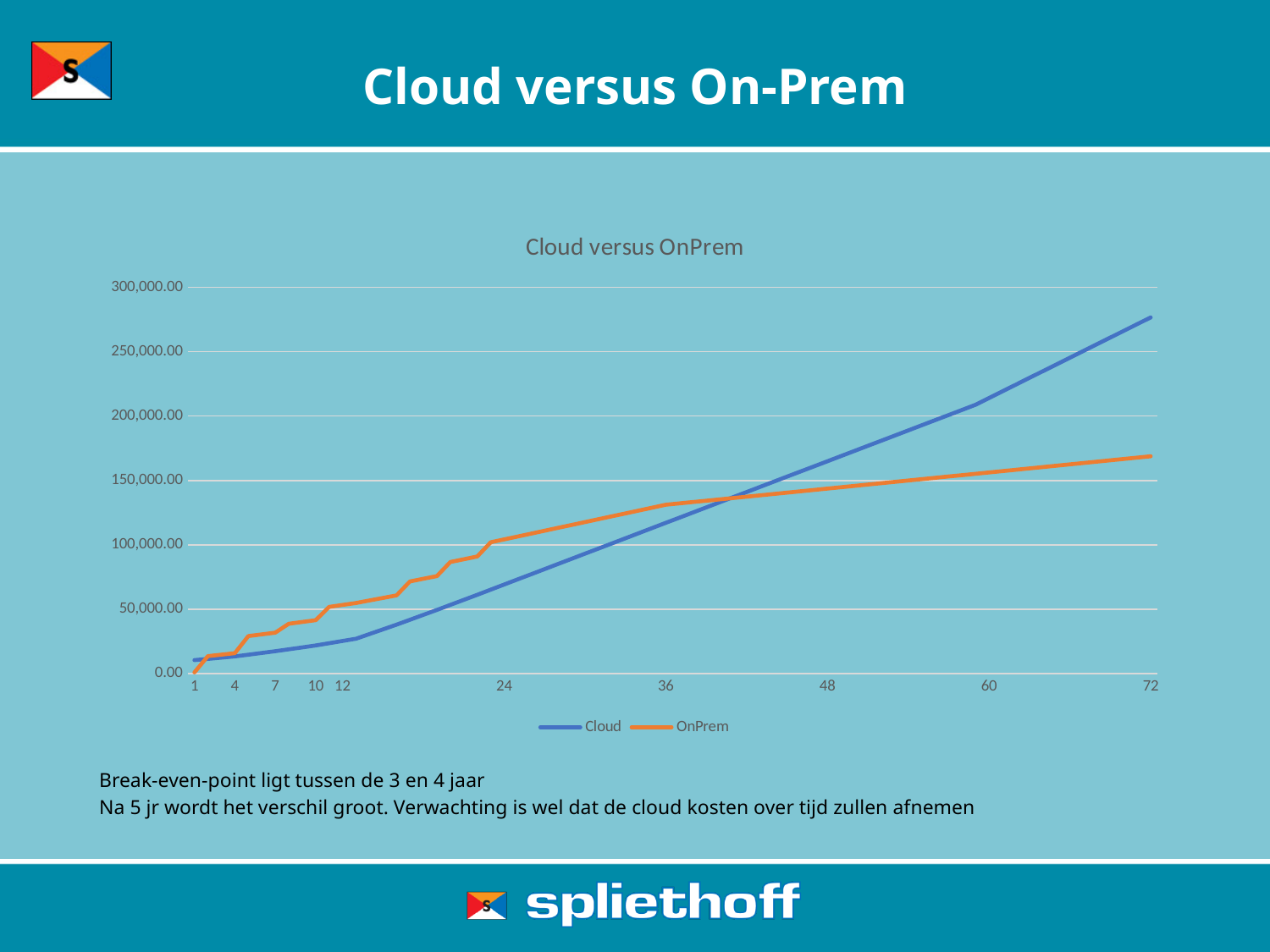
What are the names of the two series in the legend? Cloud and OnPrem Do the values of the Cloud line rise or fall along the x axis? rise How many series does the chart's legend list? 2 Is the value of the OnPrem line at 36 greater or less than 150,000.00? less At 72 on the x axis, which series has the higher value, Cloud or OnPrem? Cloud Is the value of the Cloud line at 72 greater or less than 250,000.00? greater What is the title of the chart? Cloud versus OnPrem Is the value of the OnPrem line at 72 greater or less than 200,000.00? less At 24 on the x axis, which series has the higher value, Cloud or OnPrem? OnPrem What kind of chart is shown on the slide? line chart